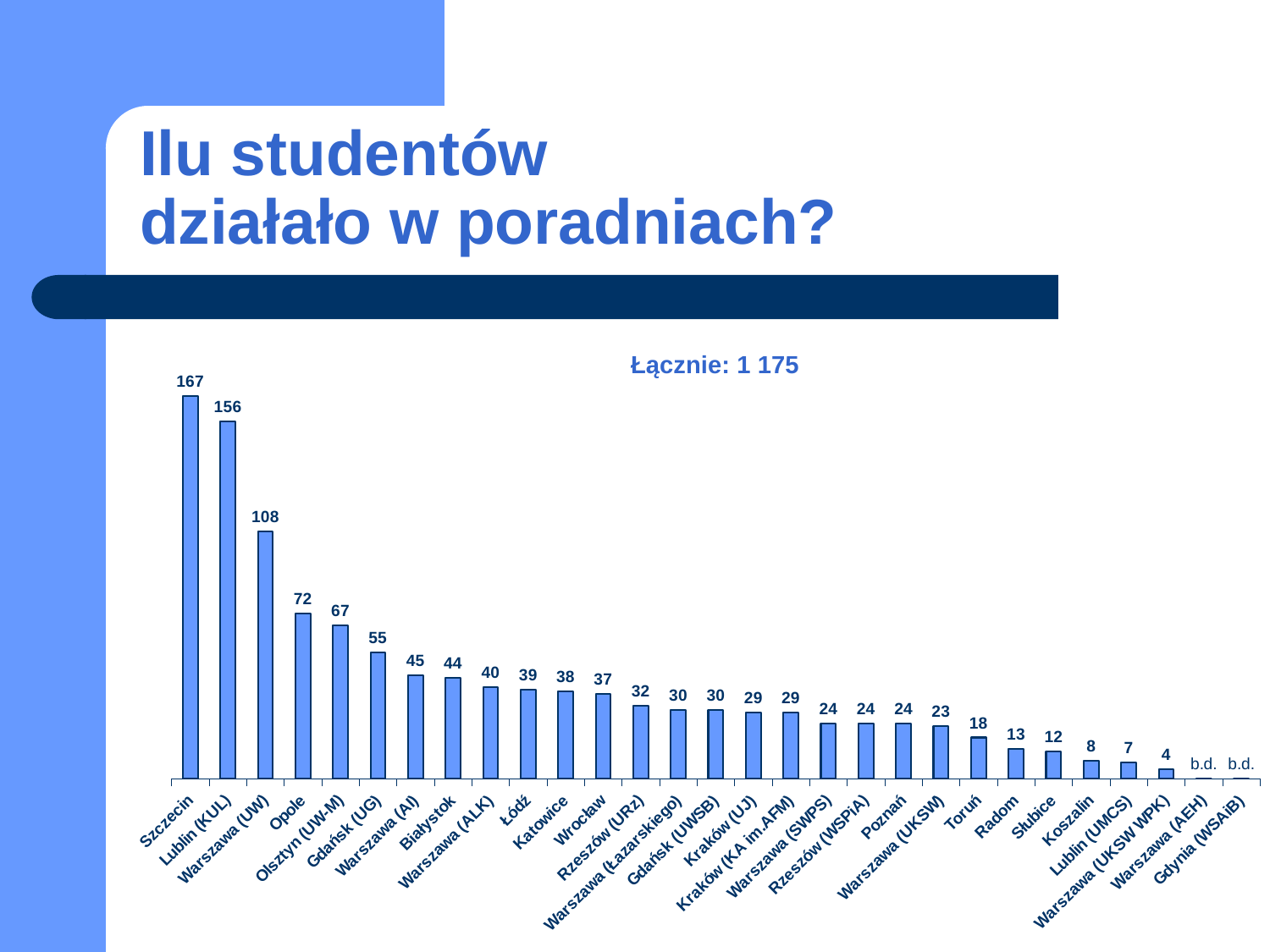
What is shown for Gdynia (WSAiB)? b.d. What value is shown for Toruń? 18 What value is shown for Warszawa (UW)? 108 What is the difference between the values for Szczecin and Lublin (KUL)? 11 What is the difference between the values for Opole and Olsztyn (UW-M)? 5 Do the values rise or fall from left to right along the x axis? fall Which is larger, the value for Białystok or the value for Łódź? Białystok Which category has the highest value? Szczecin What total (Łącznie) is printed above the chart? 1 175 What type of chart is shown on the slide? bar chart What value is shown for Szczecin? 167 Which category has the smallest numeric value shown on the chart? Warszawa (UKSW WPK)